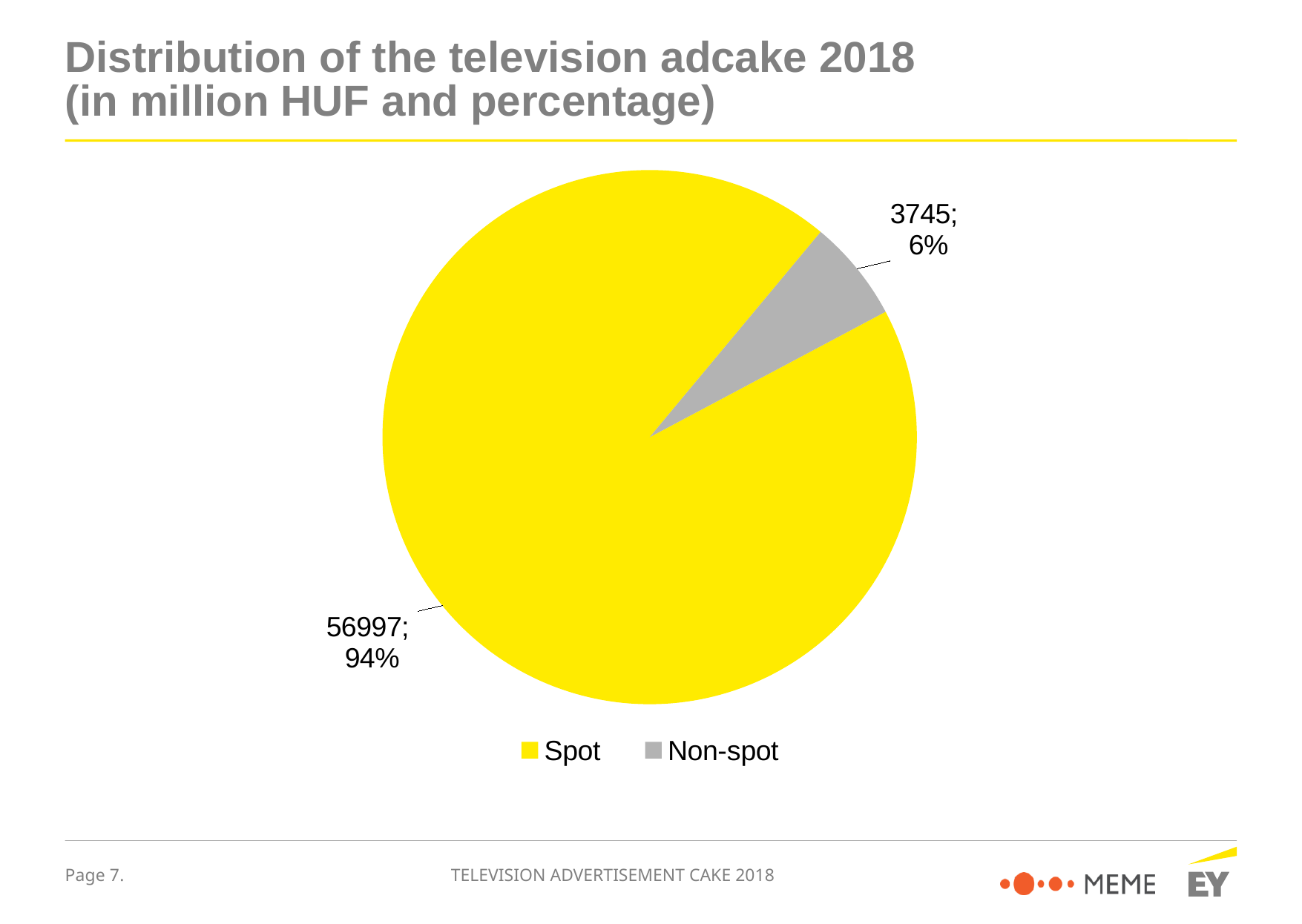
What percentage share of the pie does Spot have? 94% Which is larger, Spot or Non-spot? Spot What is the total of the two slices in million HUF? 60742 Which category has the largest slice of the pie? Spot What is the difference in million HUF between Spot and Non-spot? 53252 How many categories does the pie chart show? 2 What kind of chart is shown on the slide? pie chart What is the value for Non-spot in million HUF? 3745 What percentage share of the pie does Non-spot have? 6% What is the value for Spot in million HUF? 56997 What colour is the Non-spot slice? grey Which category has the smallest slice of the pie? Non-spot